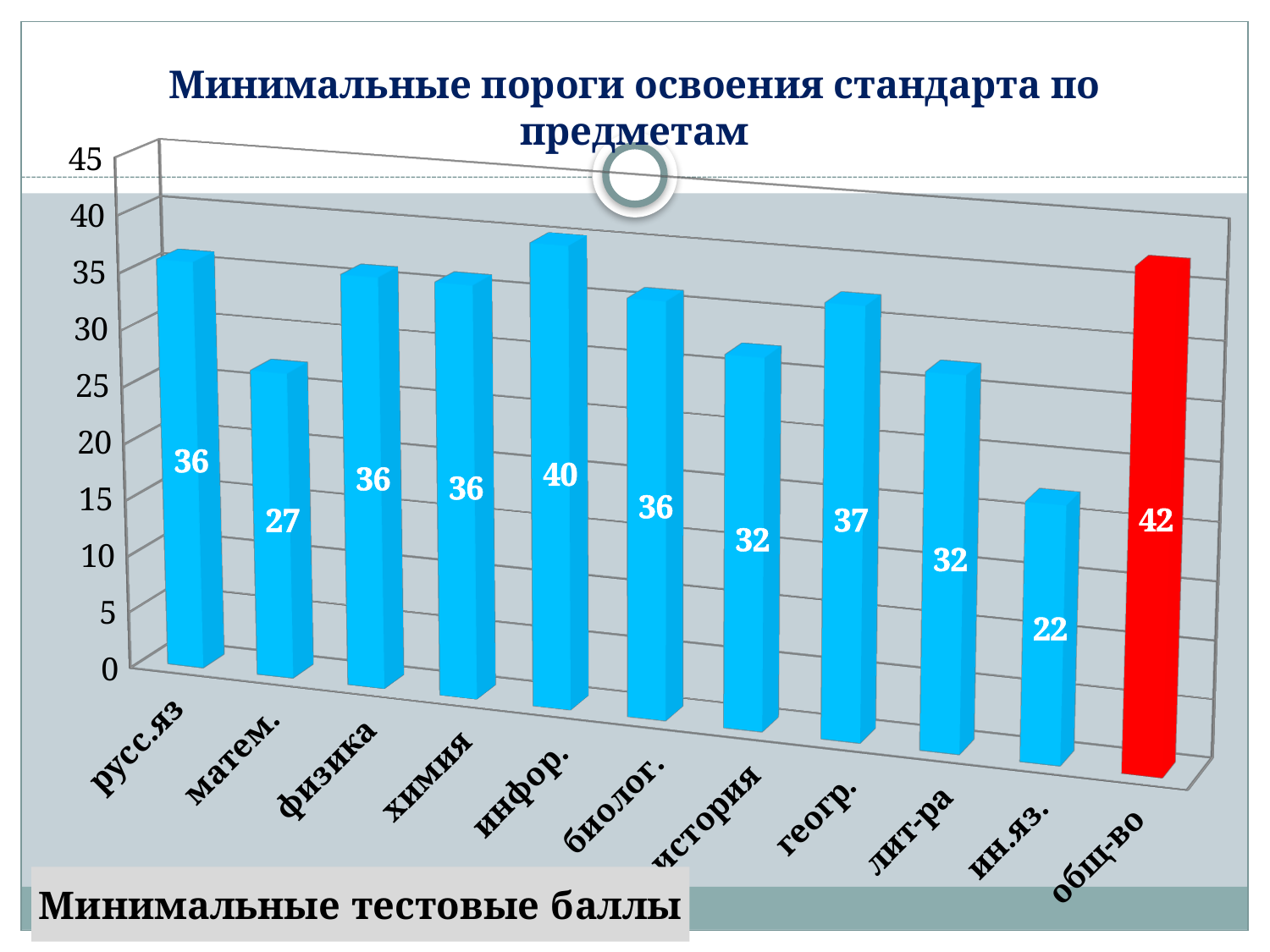
Which bar is coloured red? общ-во What is the value for русс.яз? 36 Which category has the highest value? общ-во What is the difference between the values for общ-во and ин.яз.? 20 What is the value for матем.? 27 Which is larger, the value for геогр. or the value for история? геогр. What is the value for инфор.? 40 How many categories are shown on the chart? 11 What kind of chart is shown on the slide? bar chart What is the value for ин.яз.? 22 Which category has the lowest value? ин.яз. What is the title of the chart? Минимальные пороги освоения стандарта по предметам